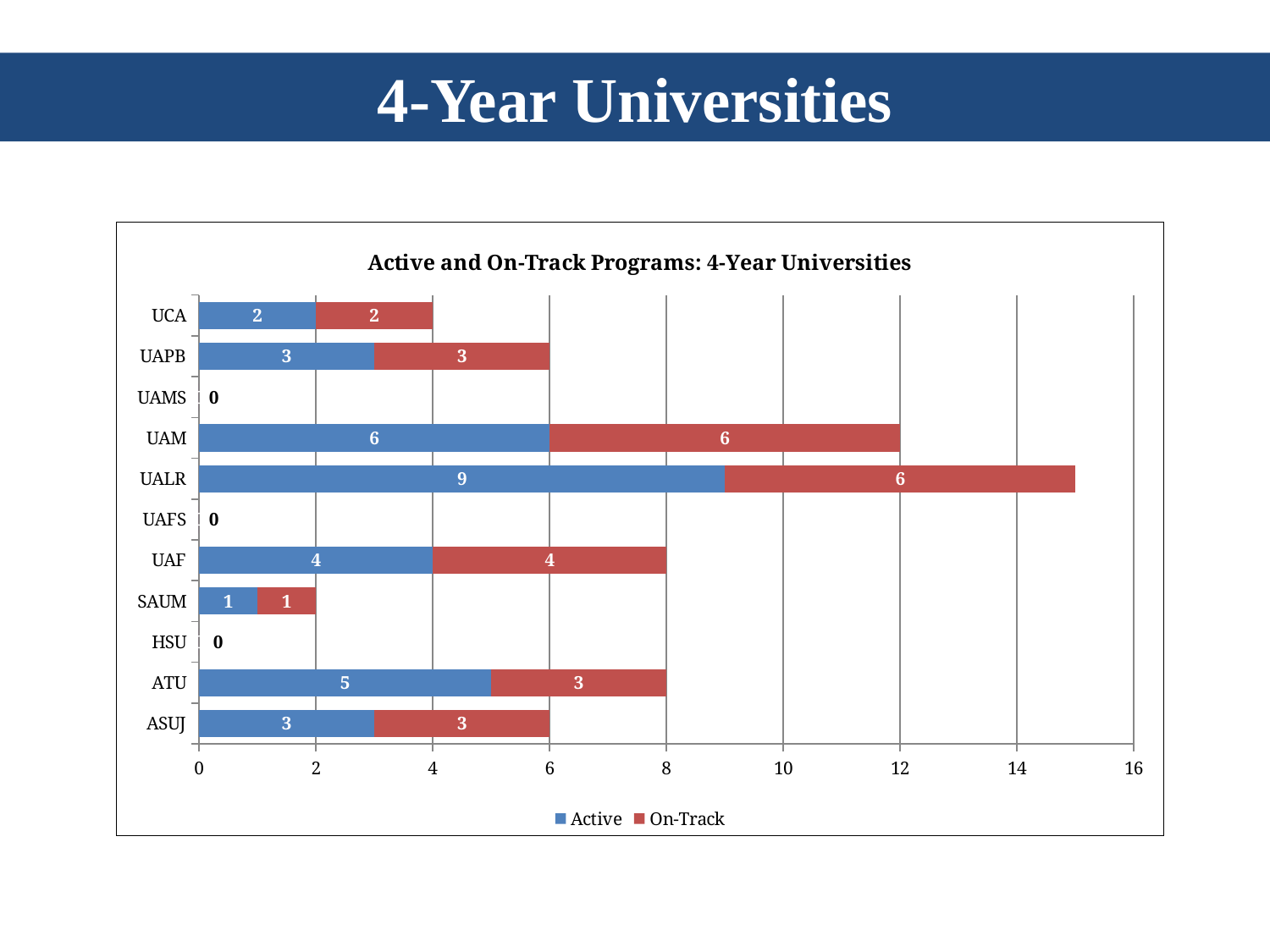
What is the On-Track value for ATU? 3 What is the title of the chart? Active and On-Track Programs: 4-Year Universities What kind of chart is shown? Stacked bar chart What is the total of the stacked bar for UAM? 12 Which university has the highest Active value? UALR What is the Active value for SAUM? 1 What is the difference between the Active values for UALR and UAM? 3 How many series does the legend list? 2 What is the Active value for UALR? 9 Which is larger, the Active value for ATU or the Active value for UAF? ATU What is the total of the stacked bar for UALR? 15 How many universities are listed on the y axis? 11